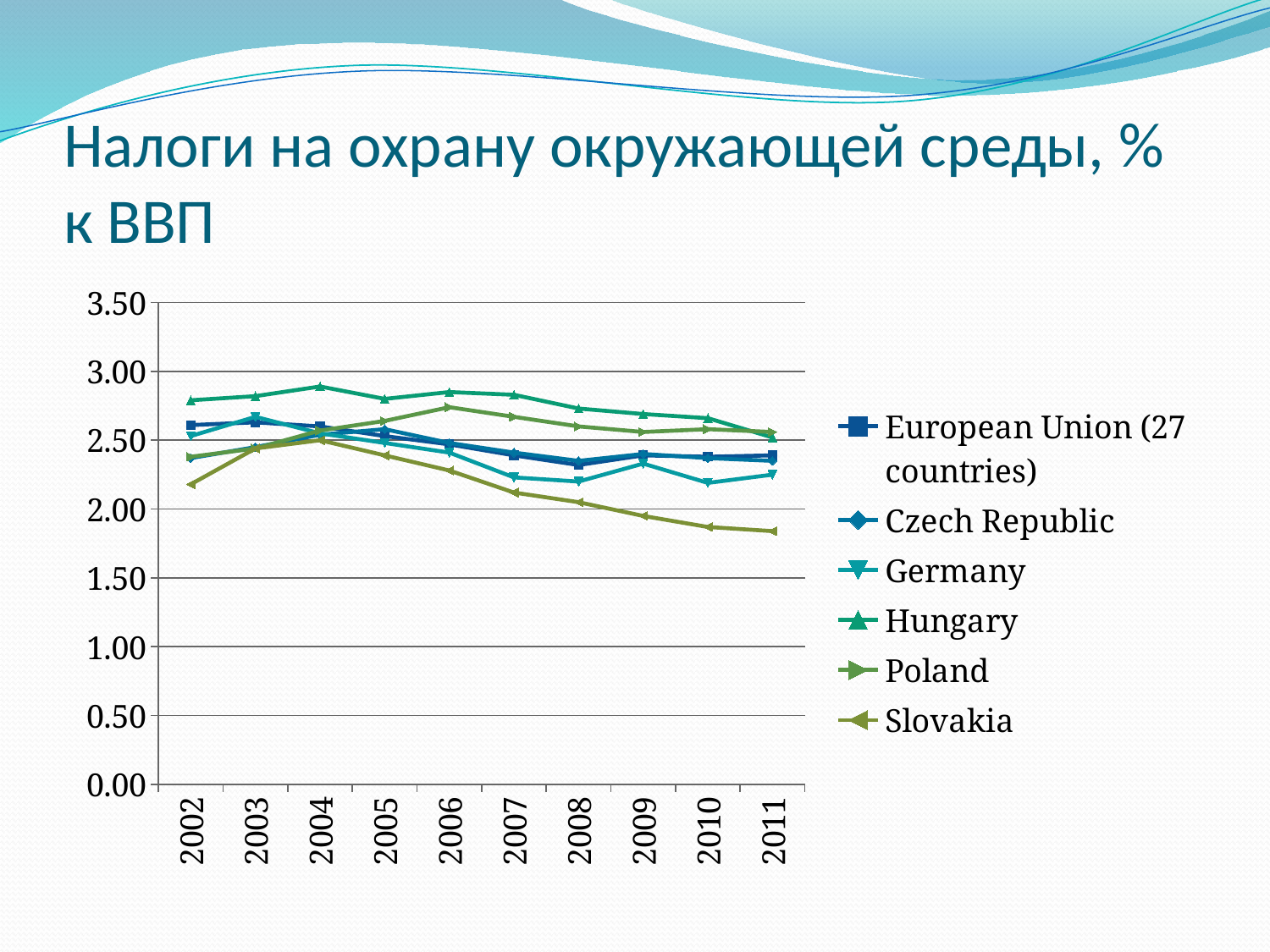
How many years are shown along the x axis? 10 Is the value for Hungary in 2002 greater or less than 3.00? less How many series does the legend list? 6 Does the value for Slovakia rise or fall from 2006 to 2011? fall Which country has the highest value in 2004? Hungary Which series is listed first in the legend? European Union (27 countries) Is the value for Slovakia in 2011 greater or less than 2.00? less What kind of chart is shown on the slide? line chart Is the value for Slovakia in 2002 greater or less than 2.50? less Which country has the lowest value in 2011? Slovakia Which is larger in 2008, the value for Poland or the value for Germany? Poland Which country has the lowest value in 2002? Slovakia